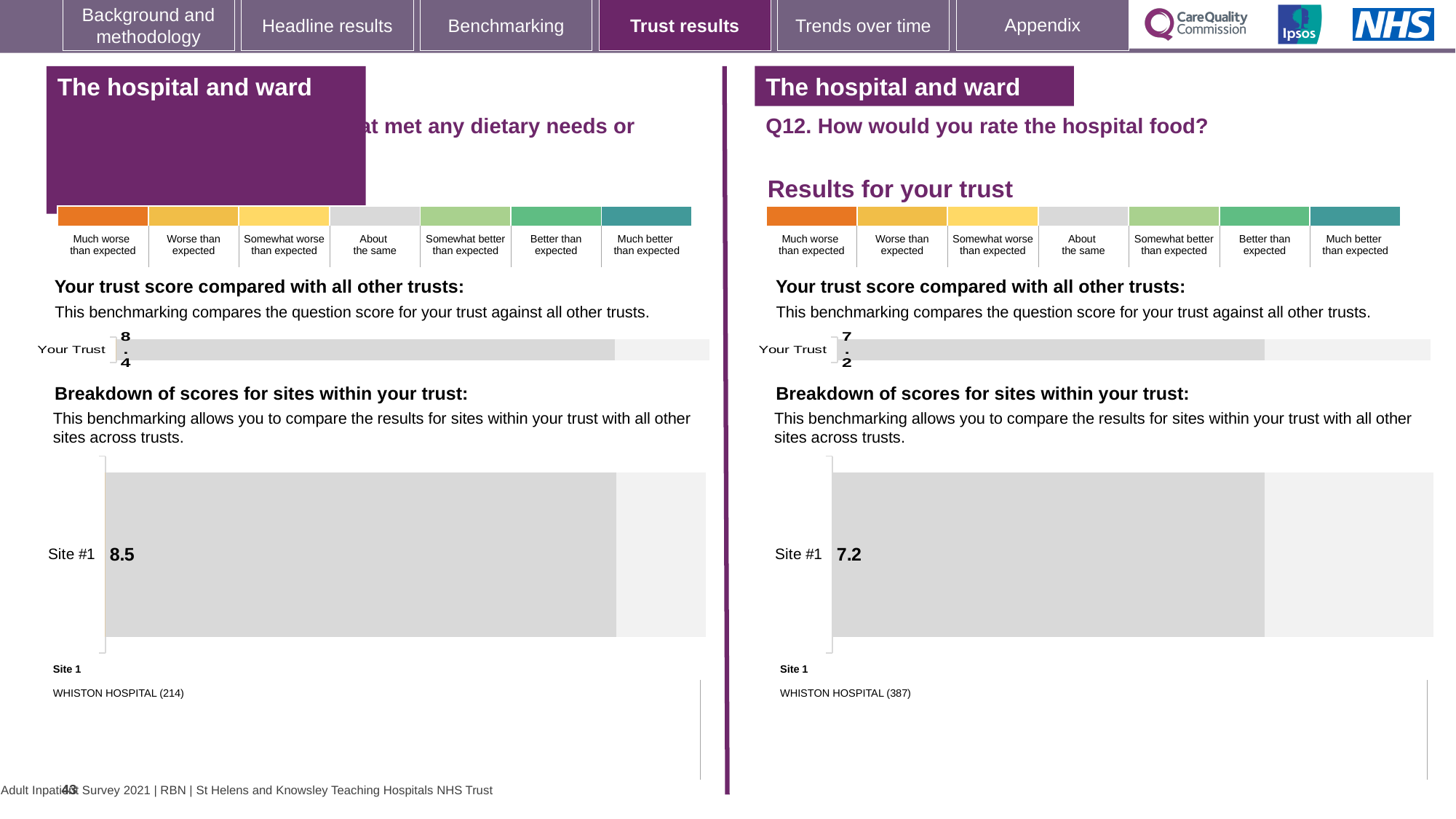
On the right-hand chart for Q12 (How would you rate the hospital food?), what is the score shown for Your Trust? 7.2 On the left-hand 'Your trust score compared with all other trusts' chart, what is the score shown for Your Trust? 8.4 How many sites are shown in the right-hand Q12 site breakdown chart? 1 Which hospital is listed as Site 1 beneath the right-hand Q12 breakdown chart? WHISTON HOSPITAL (387) On the right-hand Q12 chart, is the Your Trust score greater or less than the Site #1 score, or are they equal? Equal What type of chart is used to show the Site #1 score on the right-hand Q12 breakdown? Bar chart What is the difference between the Site #1 score on the left-hand breakdown chart (8.5) and the Site #1 score on the right-hand Q12 breakdown chart (7.2)? 1.3 What is the difference between the Your Trust score on the left-hand chart (8.4) and the Your Trust score on the right-hand Q12 chart (7.2)? 1.2 On the right-hand site breakdown chart for Q12, what is the score for Site #1? 7.2 On the left-hand site breakdown chart, what is the score for Site #1? 8.5 Which hospital is listed as Site 1 beneath the left-hand breakdown chart? WHISTON HOSPITAL (214) Which is larger: the Site #1 score on the left-hand breakdown chart or the Site #1 score on the right-hand Q12 breakdown chart? Left-hand Site #1 (8.5)